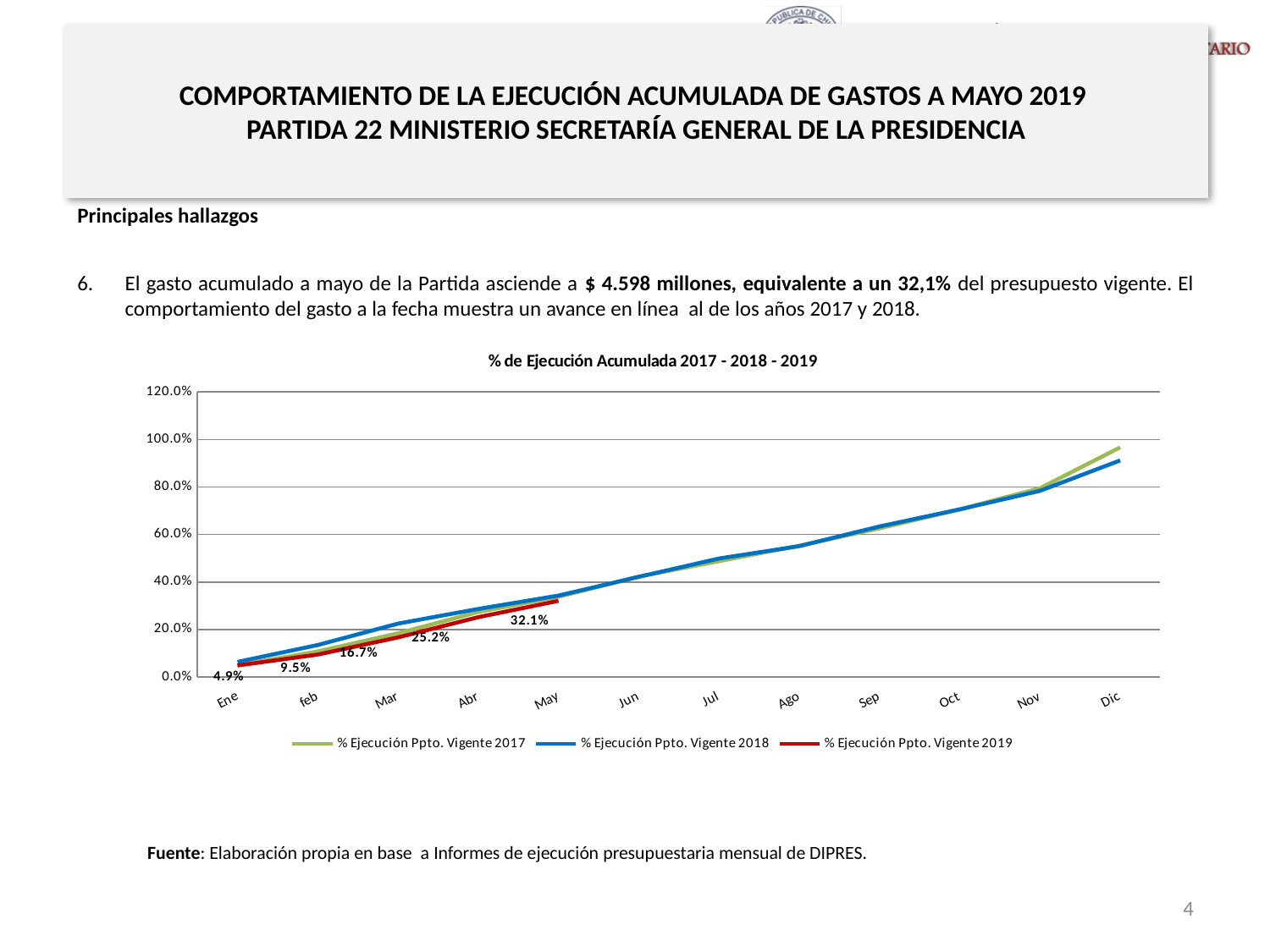
How many months are shown along the x axis of the chart? 12 Is the value for % Ejecución Ppto. Vigente 2018 in Dic greater or less than 80.0%? greater What is the value of % Ejecución Ppto. Vigente 2019 for May? 32.1% What is the title of the chart? % de Ejecución Acumulada 2017 - 2018 - 2019 What is the difference between the 2019 values for May and Abr? 6.9% Do the values of the series rise or fall from Ene to Dic? rise What is the value of % Ejecución Ppto. Vigente 2019 for Mar? 16.7% What kind of chart is shown on the slide? line chart Which month has the highest value for % Ejecución Ppto. Vigente 2019? May What is the value of % Ejecución Ppto. Vigente 2019 for Abr? 25.2% What is the value of % Ejecución Ppto. Vigente 2019 for Ene? 4.9% How many series does the chart legend list? 3